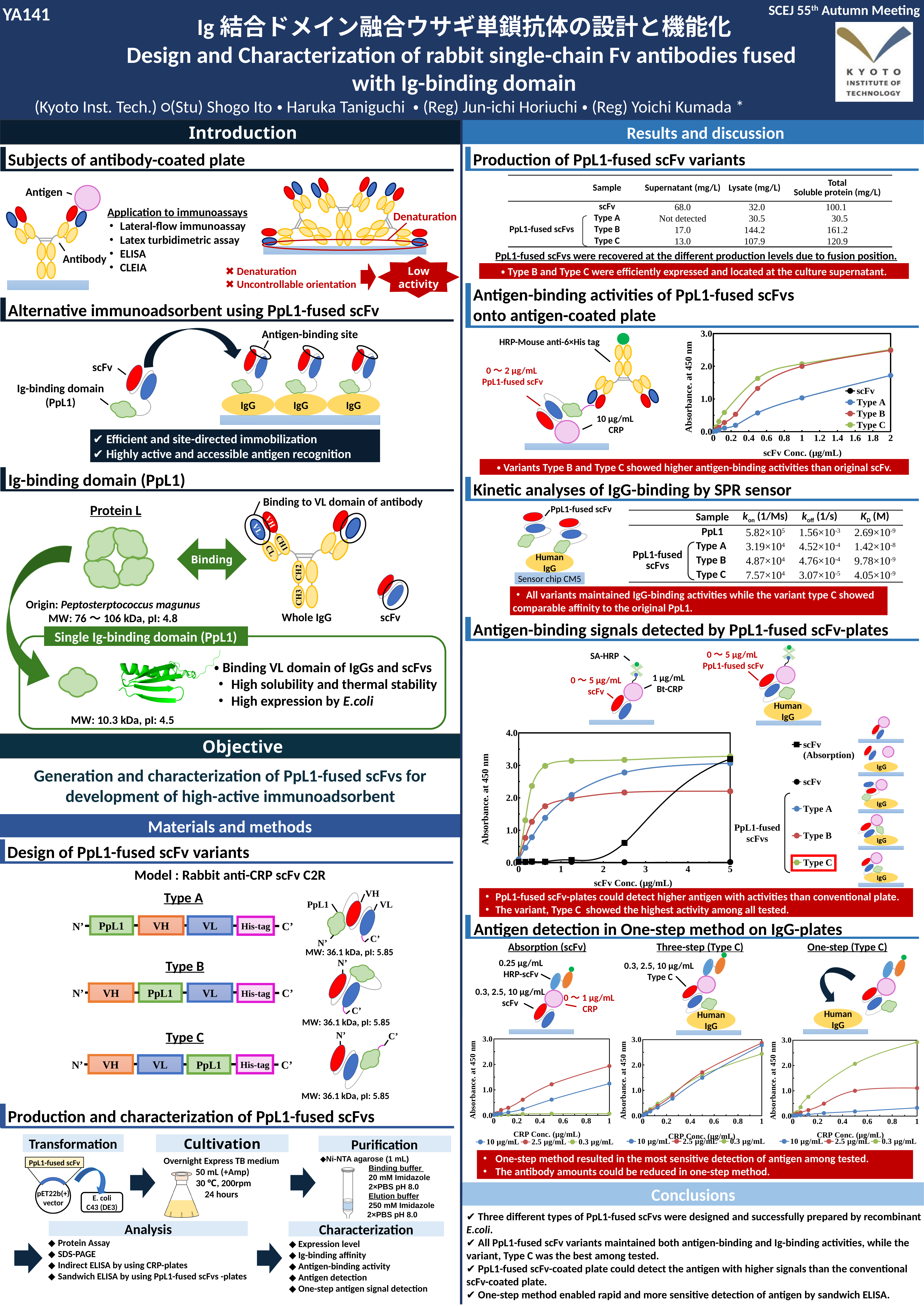
In the chart under 'Antigen-binding signals detected by PpL1-fused scFv-plates', how many series does the legend list? 5 In the chart under 'Antigen-binding activities of PpL1-fused scFvs onto antigen-coated plate', is the absorbance for Type A at 2 µg/mL greater or less than 2.0? less In the chart under 'Antigen-binding activities of PpL1-fused scFvs onto antigen-coated plate', how many series does the legend list? 4 In the chart under 'Antigen-binding activities of PpL1-fused scFvs onto antigen-coated plate', what kind of chart is shown? Line chart In the chart under 'Antigen-binding activities of PpL1-fused scFvs onto antigen-coated plate', is the absorbance for Type B at 2 µg/mL greater or less than 2.0? greater In the chart under 'Antigen-binding activities of PpL1-fused scFvs onto antigen-coated plate', which series has the highest absorbance at 0.5 µg/mL? Type C In the chart under 'Antigen-binding signals detected by PpL1-fused scFv-plates', which series has the highest absorbance at 1 µg/mL? Type C In the chart under 'Antigen-binding signals detected by PpL1-fused scFv-plates', is the absorbance for Type B at 5 µg/mL greater or less than 3.0? less In the chart under 'Antigen-binding signals detected by PpL1-fused scFv-plates', what is the label of the x axis? scFv Conc. (µg/mL) In the chart under 'Antigen-binding signals detected by PpL1-fused scFv-plates', at 2.5 µg/mL, which is larger: Type A or scFv (Absorption)? Type A In the chart under 'Antigen-binding activities of PpL1-fused scFvs onto antigen-coated plate', does the absorbance rise or fall as scFv concentration increases? rise